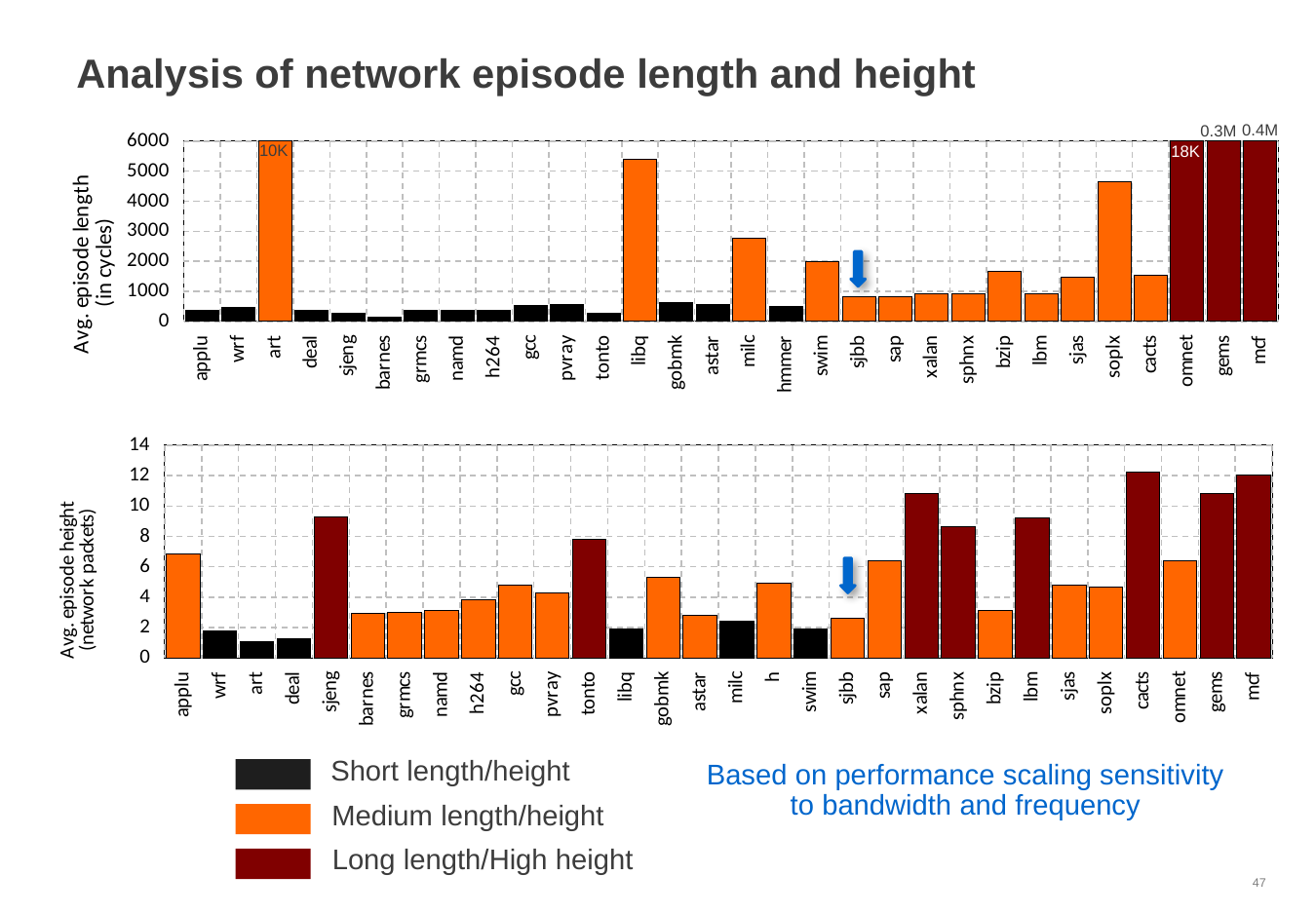
In the bottom chart (Avg. episode height), which is larger, the value for sjeng or the value for barnes? sjeng In the top chart (Avg. episode length), is the value for milc greater or less than 3000? less In the bottom chart (Avg. episode height), is the value for xalan greater or less than 10? greater How many categories are shown along the x axis of the top chart (Avg. episode length)? 30 In the top chart (Avg. episode length), what value is printed on the bar for omnet? 18K In the top chart (Avg. episode length), what value is printed above the bar for mcf? 0.4M In the top chart (Avg. episode length), is the value for libq greater or less than 5000? greater What kind of chart is the top chart on the slide? bar chart In the top chart (Avg. episode length), what value is printed on the bar for art? 10K How many entries does the legend at the bottom of the slide list? 3 In the top chart (Avg. episode length), what value is printed above the bar for gems? 0.3M In the top chart (Avg. episode length), which category has the highest value? mcf